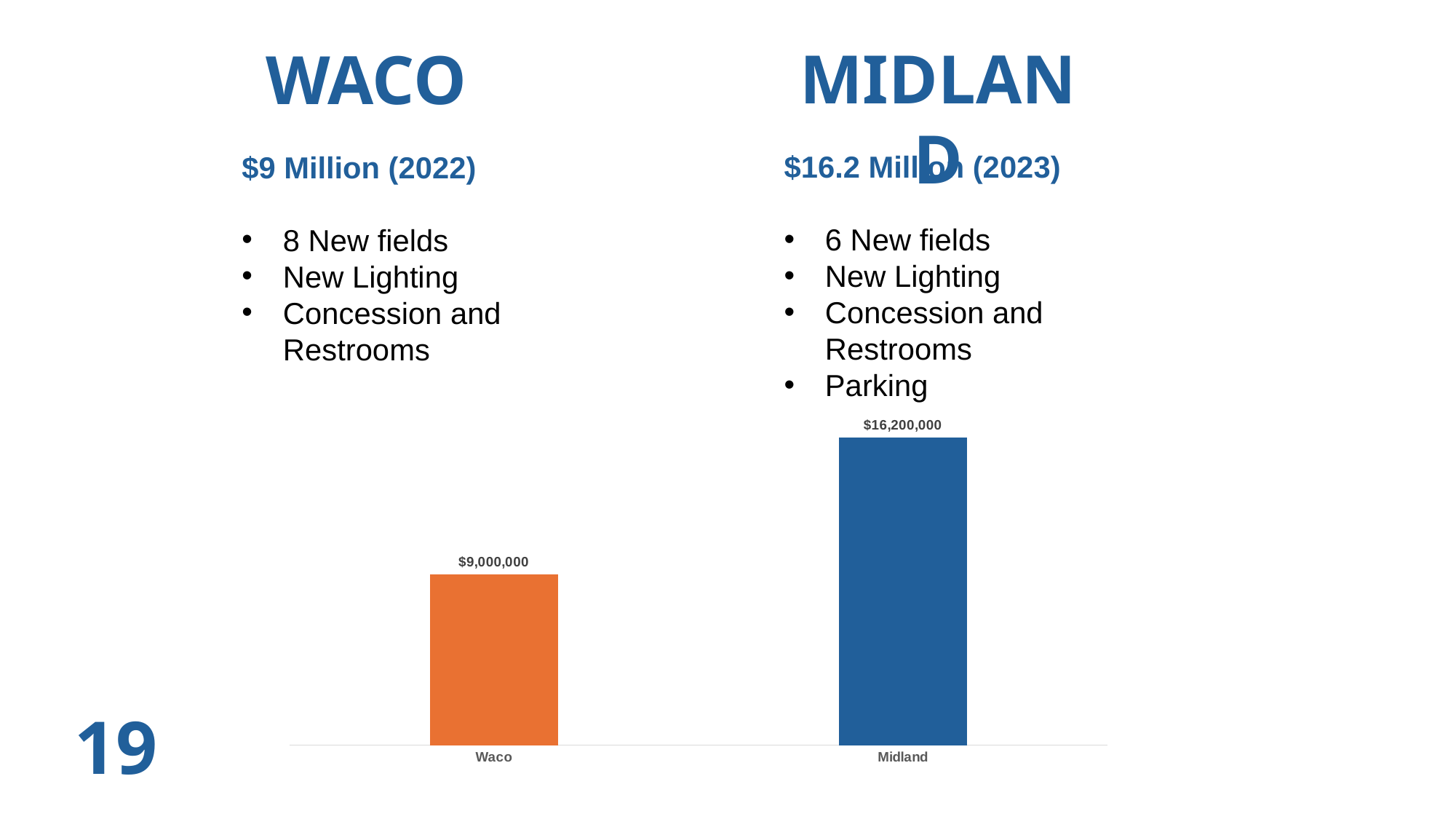
What is the value shown for Waco in the bar chart? $9,000,000 Which is larger in the bar chart, the value for Waco or the value for Midland? Midland Which category has the highest value in the bar chart? Midland How many categories are shown in the bar chart? 2 What kind of chart is shown on the slide? Bar chart What colour is the Waco bar in the chart? Orange What colour is the Midland bar in the chart? Blue What is the difference between the Midland and Waco values in the bar chart? $7,200,000 What is the value shown for Midland in the bar chart? $16,200,000 Which category has the lowest value in the bar chart? Waco